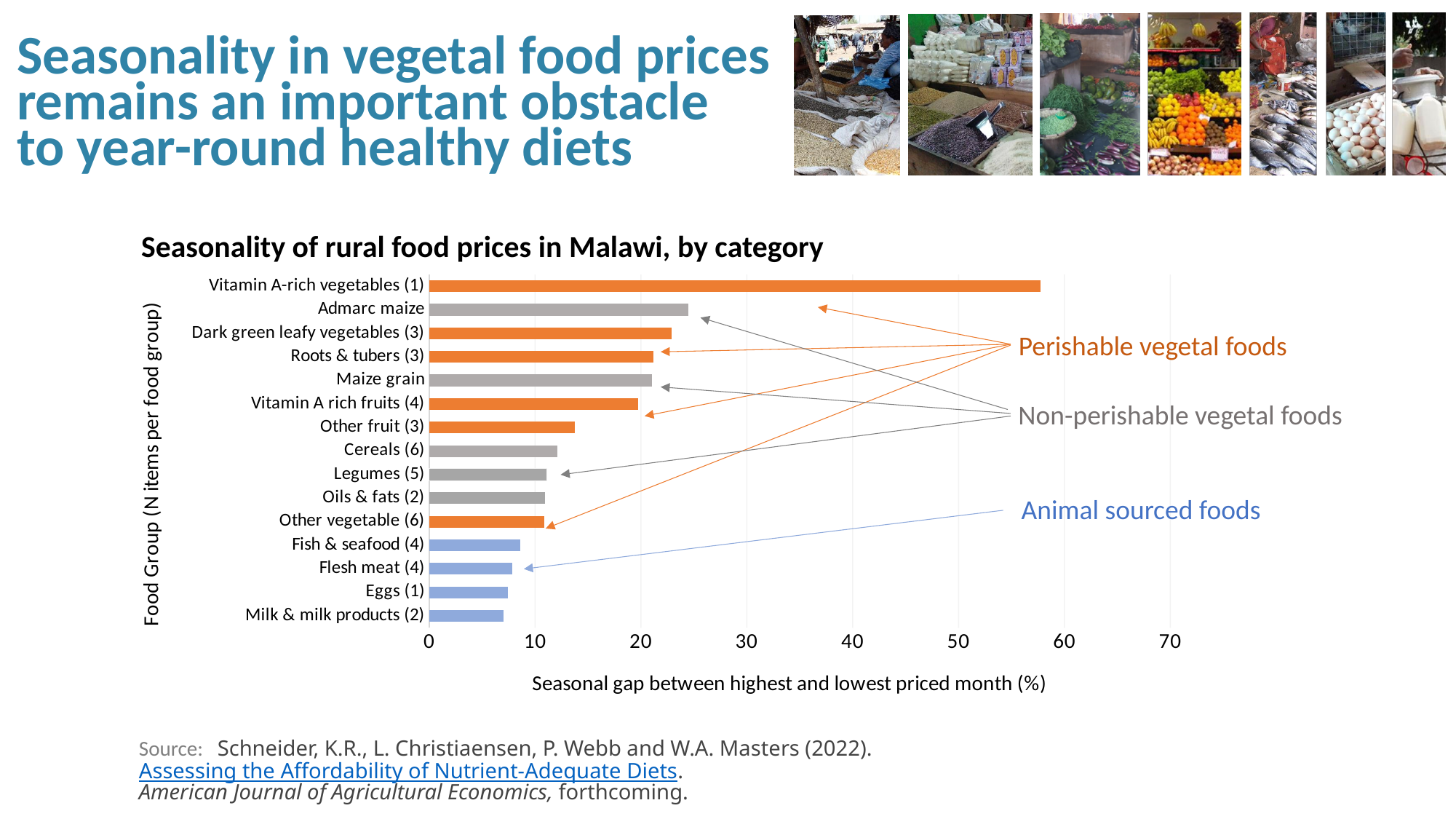
Is the value for Vitamin A-rich vegetables (1) greater or less than 50? greater Which has a larger seasonal gap, Admarc maize or Other fruit (3)? Admarc maize Which has a larger seasonal gap, Other fruit (3) or Fish & seafood (4)? Other fruit (3) Is the value for Fish & seafood (4) greater or less than 10? less Is the value for Other fruit (3) greater or less than 20? less What type of chart is shown on the slide? Bar chart Which colour is used for the bars labelled as perishable vegetal foods? Orange How many food groups are plotted in the chart? 15 Which food group has the largest seasonal gap in the chart? Vitamin A-rich vegetables (1) What is the title of the chart? Seasonality of rural food prices in Malawi, by category